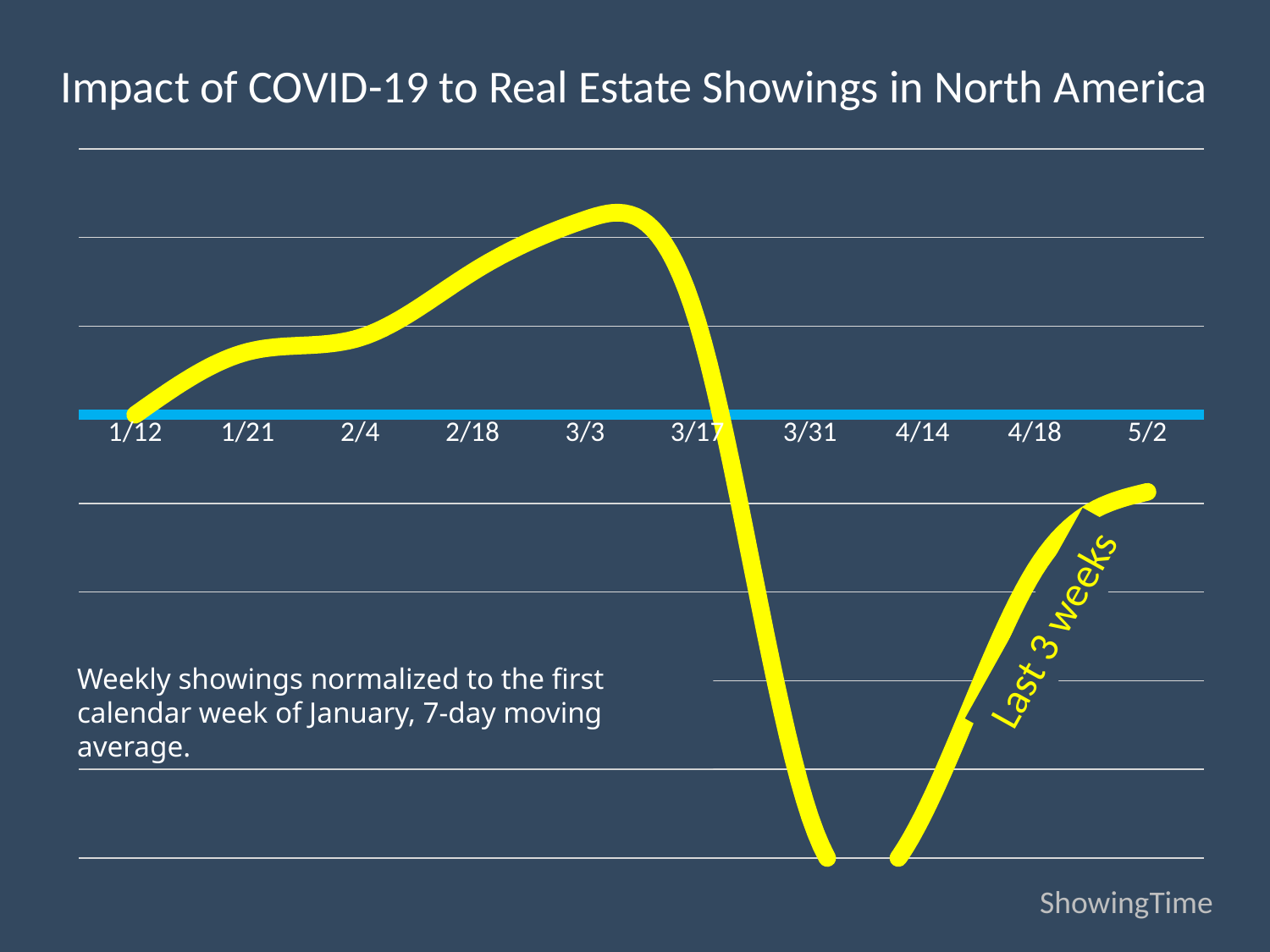
Does the line rise or fall between 4/14 and 5/2? rise Does the line rise or fall between 1/12 and 3/3? rise Which is higher, the value at 1/12 or the value at 3/3? 3/3 What kind of chart is shown on the slide? line chart Does the line rise or fall between 3/17 and 3/31? fall Which is higher, the value at 1/12 or the value at 5/2? 1/12 What is the first date label on the x axis? 1/12 Which is higher, the value at 3/31 or the value at 5/2? 5/2 How many date labels are shown on the x axis? 10 What is the title of the chart? Impact of COVID-19 to Real Estate Showings in North America